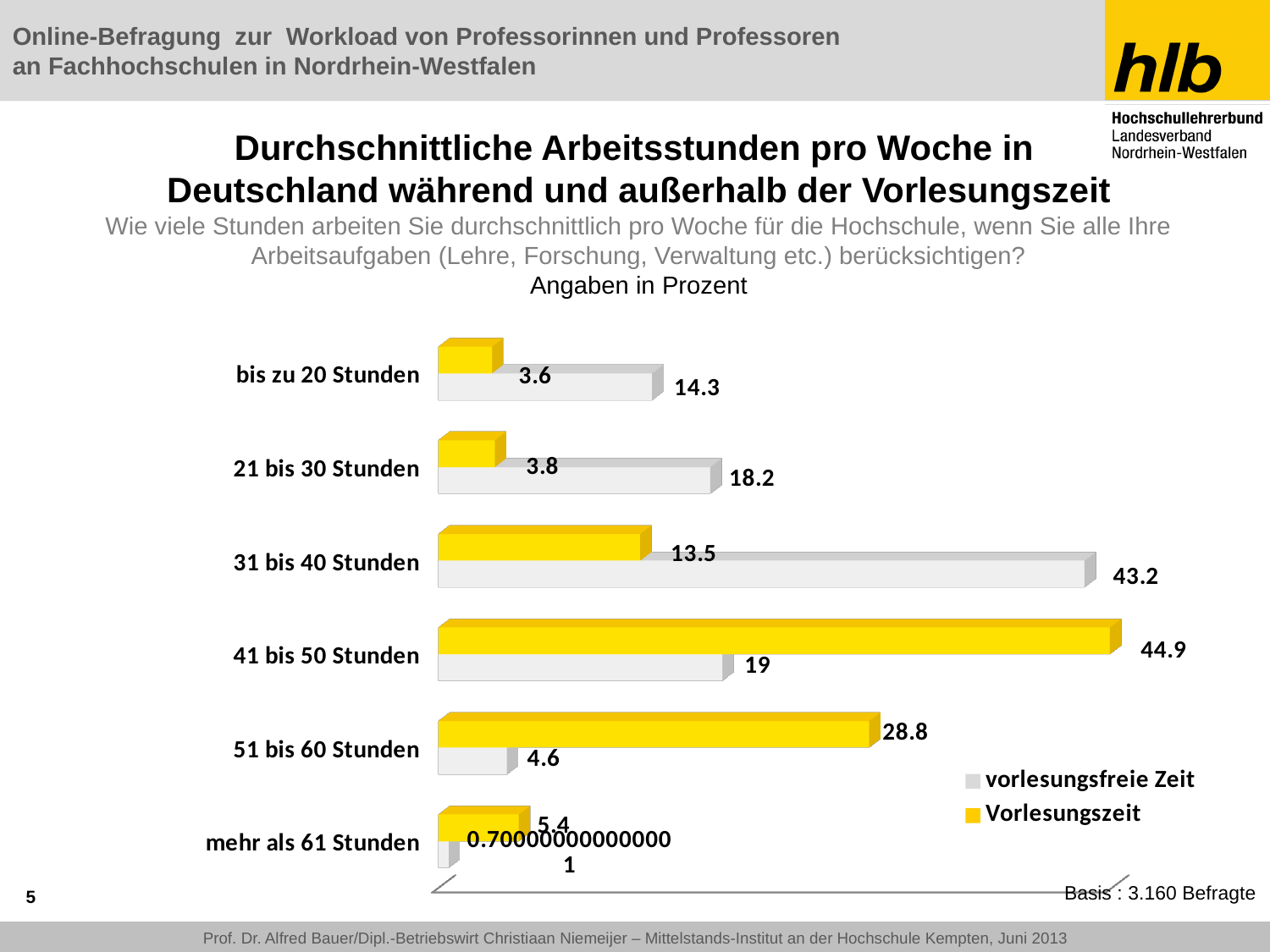
What kind of chart is shown on the slide? bar chart What is the value for vorlesungsfreie Zeit in the category 'bis zu 20 Stunden'? 14.3 How many series does the legend list? 2 What is the value for vorlesungsfreie Zeit in the category '31 bis 40 Stunden'? 43.2 What is the value for Vorlesungszeit in the category '51 bis 60 Stunden'? 28.8 What is the difference between the vorlesungsfreie Zeit and Vorlesungszeit values for '21 bis 30 Stunden'? 14.4 Which category has the highest value for Vorlesungszeit? 41 bis 50 Stunden Which category has the highest value for vorlesungsfreie Zeit? 31 bis 40 Stunden For '41 bis 50 Stunden', which series has the larger value: Vorlesungszeit or vorlesungsfreie Zeit? Vorlesungszeit What is the value for Vorlesungszeit in the category '41 bis 50 Stunden'? 44.9 Which colour represents the series 'Vorlesungszeit' in the legend? yellow How many categories (hour ranges) are shown on the chart? 6